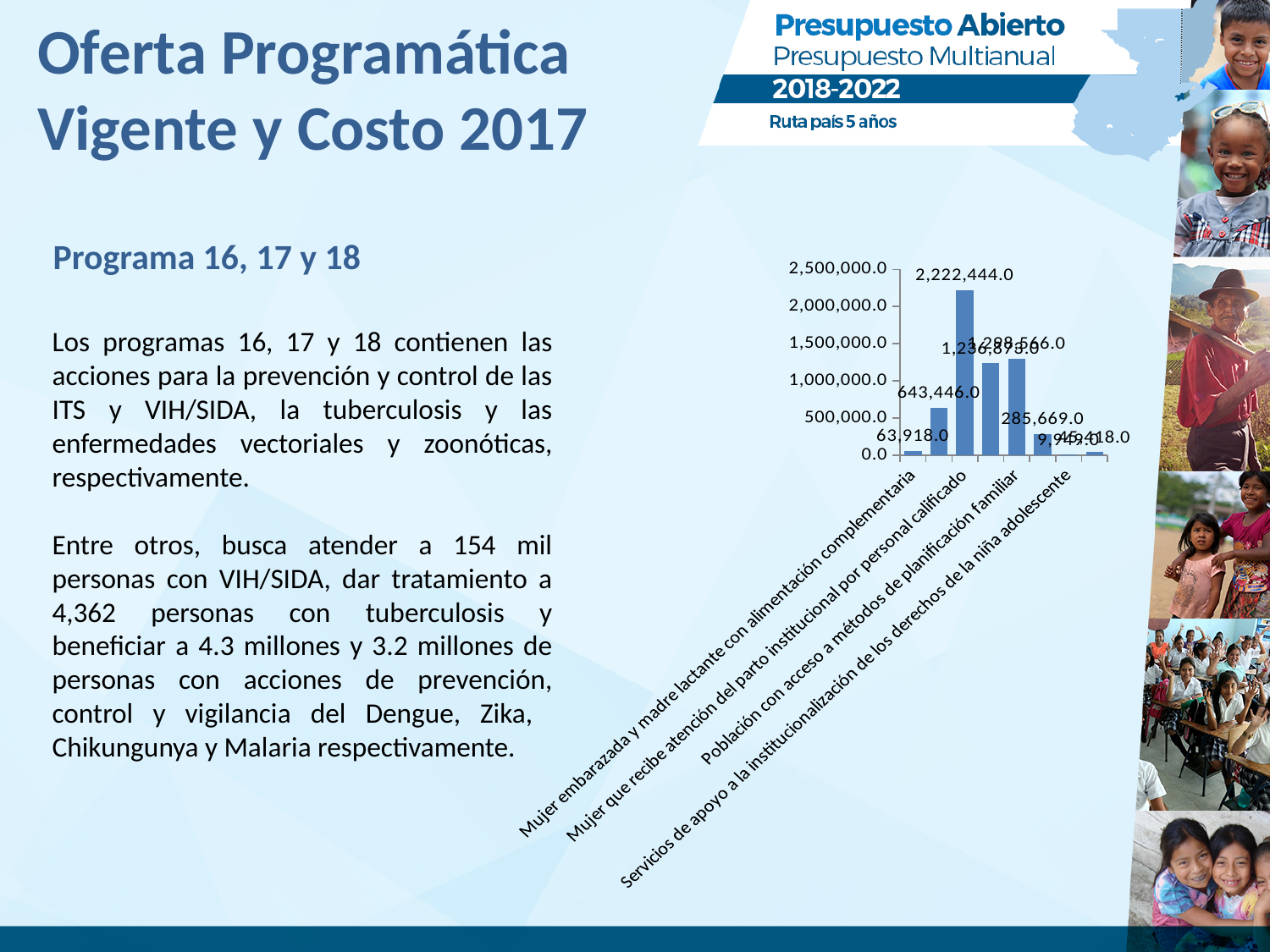
What is the value of the second bar from the left in the chart? 643,446.0 Is the value of the second bar from the left greater or less than 1,000,000.0? less What is the value of the first bar from the left in the chart? 63,918.0 What is the value of the tallest bar in the chart? 2,222,444.0 Is the value of the tallest bar greater or less than 2,000,000.0? greater How many bars does the chart contain? 8 What kind of chart is shown on the slide? bar chart What is the value of the sixth bar from the left in the chart? 285,669.0 What is the highest value shown on the vertical axis of the chart? 2,500,000.0